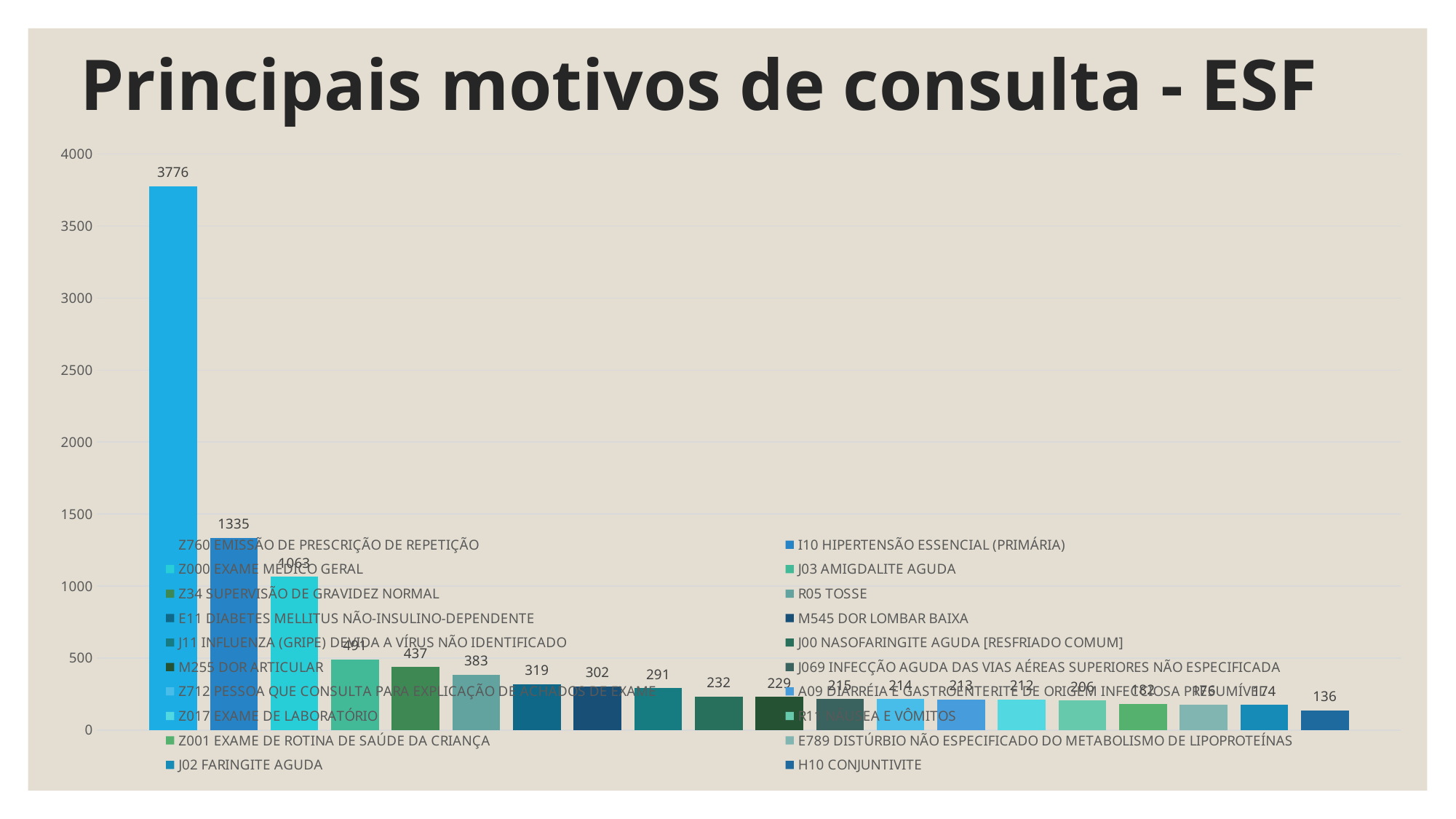
What is the value of the second bar, I10 HIPERTENSÃO ESSENCIAL (PRIMÁRIA)? 1335 What is the title of the chart? Principais motivos de consulta - ESF How many entries does the legend list? 20 Which is larger, the bar with value 491 or the bar with value 437? 491 What is the lowest value shown in the chart? 136 What type of chart is shown on the slide? bar chart Is the value of the third bar (1063) greater or less than 1000? greater How many bars are plotted in the chart? 20 What is the highest value shown in the chart? 3776 What is the value of the tallest bar, labelled Z760 EMISSÃO DE PRESCRIÇÃO DE REPETIÇÃO? 3776 Do the bar values rise or fall from left to right across the chart? fall What is the difference between the two tallest bars (3776 and 1335)? 2441